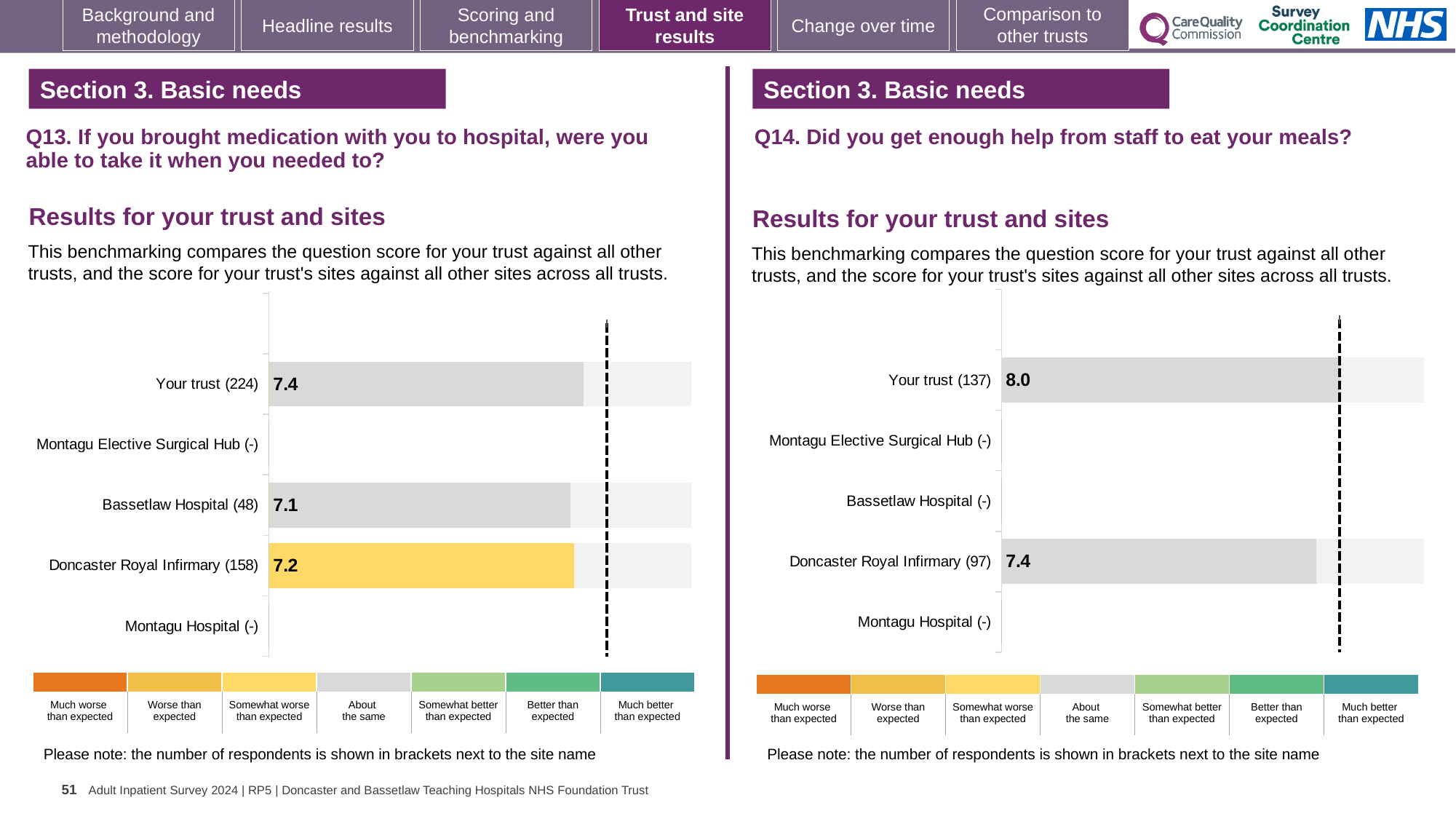
In the Q14 chart on the right, what is the difference between the score for Your trust and the score for Doncaster Royal Infirmary? 0.6 What type of chart is used for the Q13 results on the left? Bar chart In the Q13 chart on the left, which site's bar is coloured yellow (somewhat worse than expected)? Doncaster Royal Infirmary (158) In the Q13 chart on the left, what is the difference between the score for Your trust and the score for Bassetlaw Hospital? 0.3 In the Q13 chart on the left, what is the score for Your trust (224)? 7.4 How many site/trust categories are listed on the y axis of the Q14 chart on the right? 5 In the Q14 chart on the right, what is the score for Doncaster Royal Infirmary (97)? 7.4 In the Q13 chart on the left, what is the score for Bassetlaw Hospital (48)? 7.1 In the Q13 chart on the left, which site has the lowest score among those with a value shown? Bassetlaw Hospital (48) In the Q13 chart on the left, which is larger: the score for Doncaster Royal Infirmary or the score for Bassetlaw Hospital? Doncaster Royal Infirmary In the Q13 chart on the left, what is the score for Doncaster Royal Infirmary (158)? 7.2 In the Q14 chart on the right, what is the score for Your trust (137)? 8.0